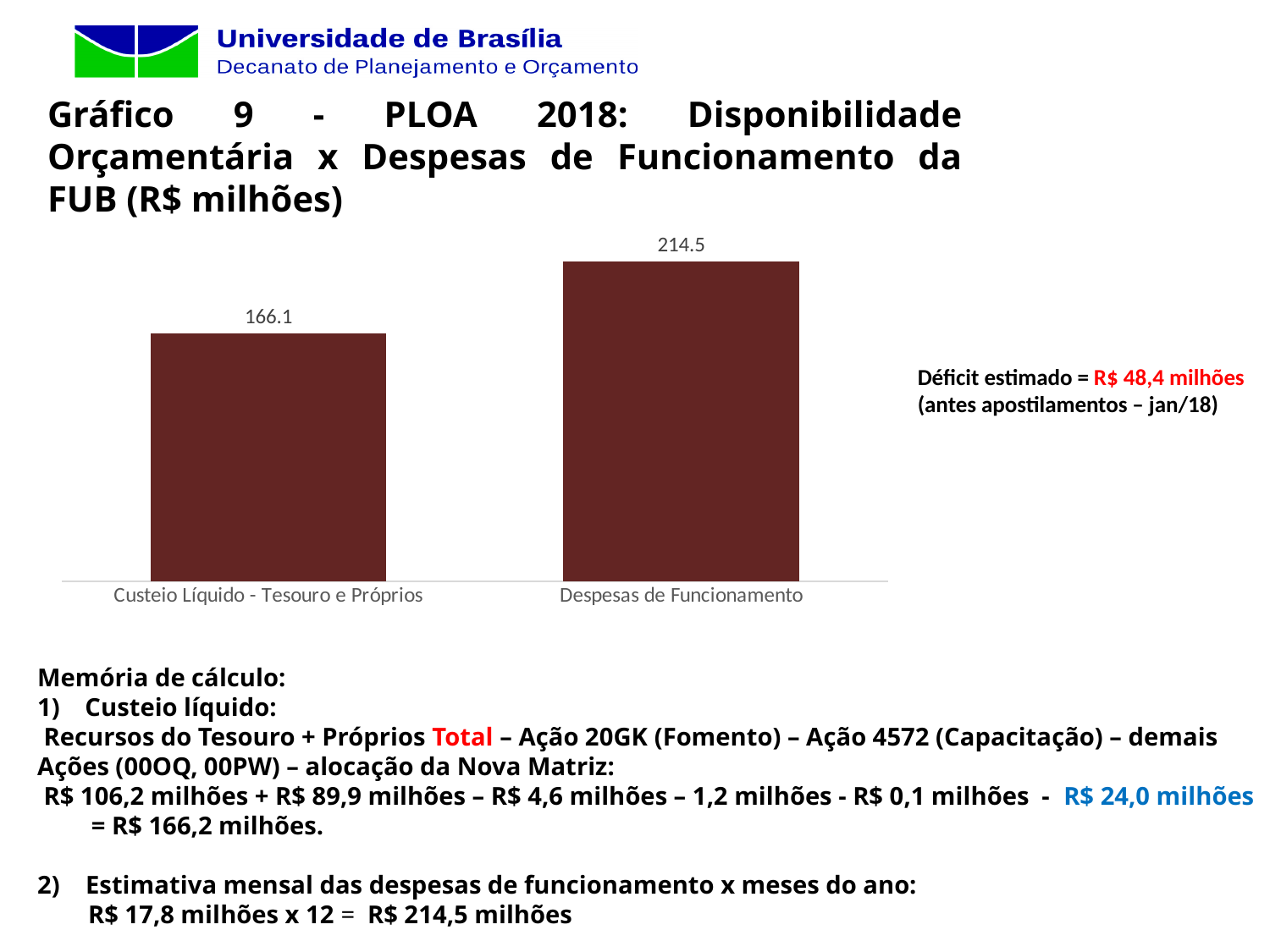
What is the difference between Despesas de Funcionamento and Custeio Líquido - Tesouro e Próprios? 48.4 Which is larger, Custeio Líquido - Tesouro e Próprios or Despesas de Funcionamento? Despesas de Funcionamento What is the value for Custeio Líquido - Tesouro e Próprios? 166.1 What is the value for Despesas de Funcionamento? 214.5 Which category has the highest value? Despesas de Funcionamento What is the title of the chart? Gráfico 9 - PLOA 2018: Disponibilidade Orçamentária x Despesas de Funcionamento da FUB (R$ milhões) What kind of chart is shown on the slide? Bar chart How many categories are shown in the chart? 2 Do the values rise or fall from left to right across the categories? Rise Which category has the lowest value? Custeio Líquido - Tesouro e Próprios What colour are the bars in the chart? Dark red